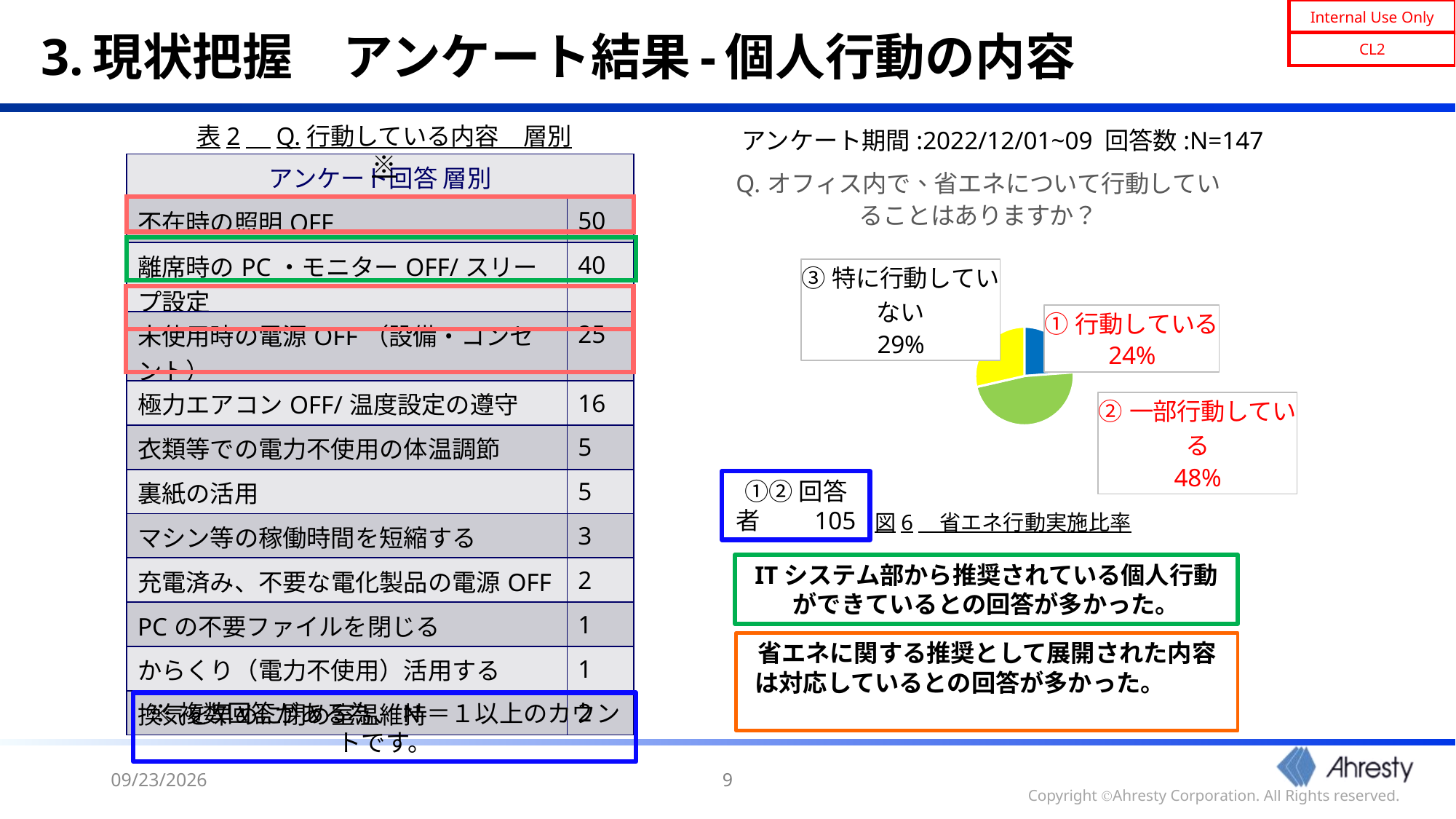
In the pie chart (図6 省エネ行動実施比率), what share is labelled for ① 行動している? 24% In the pie chart (図6 省エネ行動実施比率), which category has the smallest share? ① 行動している What is the figure caption of the pie chart on the slide? 図6 省エネ行動実施比率 In the pie chart (図6 省エネ行動実施比率), what share is labelled for ③ 特に行動していない? 29% In the pie chart (図6 省エネ行動実施比率), which category has the largest share? ② 一部行動している In the pie chart (図6 省エネ行動実施比率), what is the difference in percentage points between ③ 特に行動していない and ① 行動している? 5 In the pie chart (図6 省エネ行動実施比率), which is larger: the share for ② 一部行動している or the share for ③ 特に行動していない? ② 一部行動している What kind of chart is shown under the question 'Q. オフィス内で、省エネについて行動していることはありますか？'? pie chart What is the number of respondents (N) stated for the survey shown in the pie chart? N=147 In the pie chart (図6 省エネ行動実施比率), what share is labelled for ② 一部行動している? 48% In the pie chart (図6 省エネ行動実施比率), what is the difference in percentage points between ② 一部行動している and ① 行動している? 24 In the pie chart (図6 省エネ行動実施比率), how many slices are there? 3